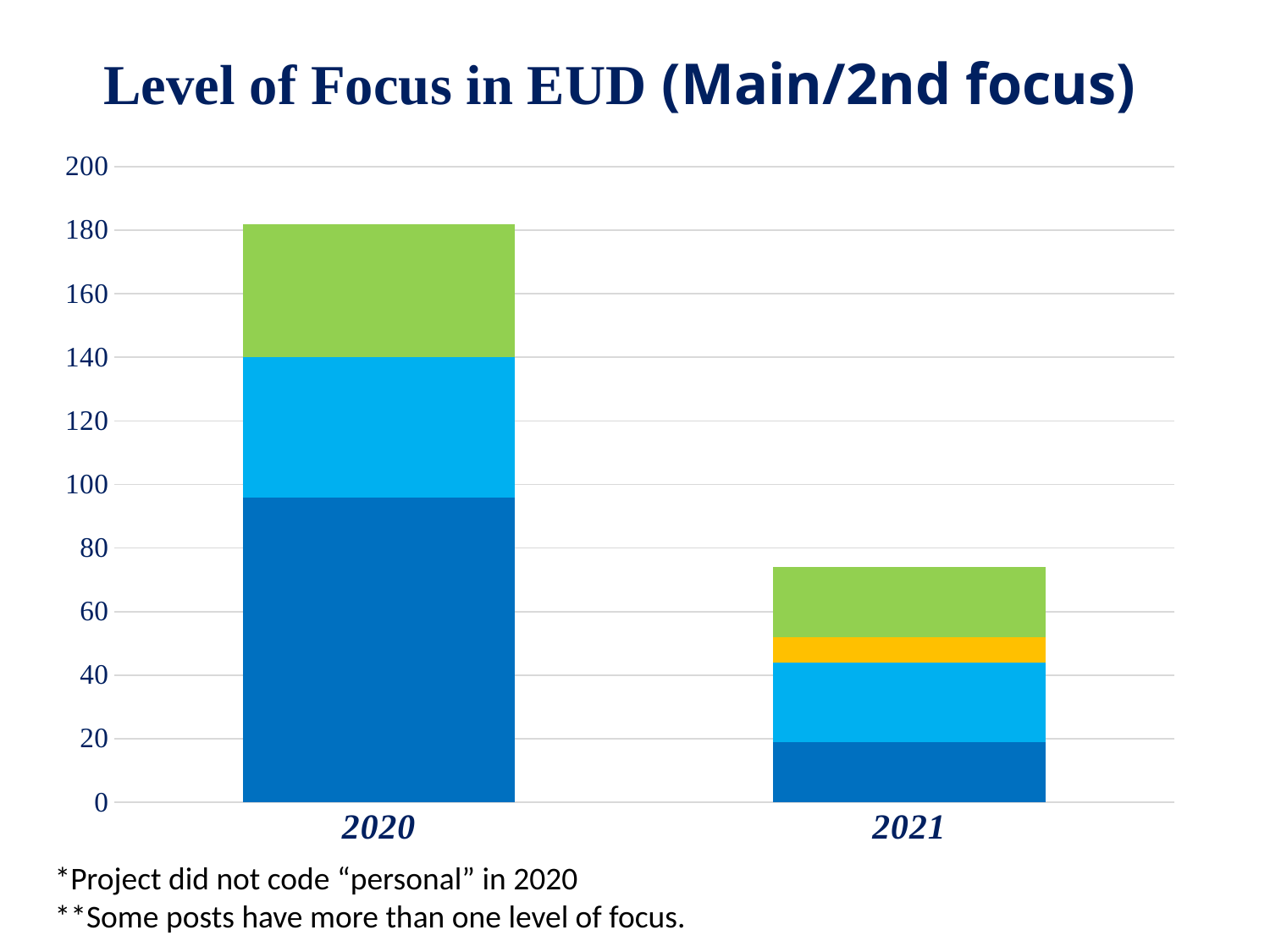
What kind of chart is shown on the slide? Stacked bar chart Is the dark blue segment of the 2020 bar greater or less than 80? greater How many categories are shown on the x axis? 2 Which category has the lowest total bar height? 2021 What is the title of the chart? Level of Focus in EUD (Main/2nd focus) Is the total height of the 2021 bar greater or less than 80? less Is the total height of the 2021 bar greater or less than 60? greater Do the total bar heights rise or fall from 2020 to 2021? fall Which year has the taller stacked bar, 2020 or 2021? 2020 How many coloured segments make up the 2021 bar? 4